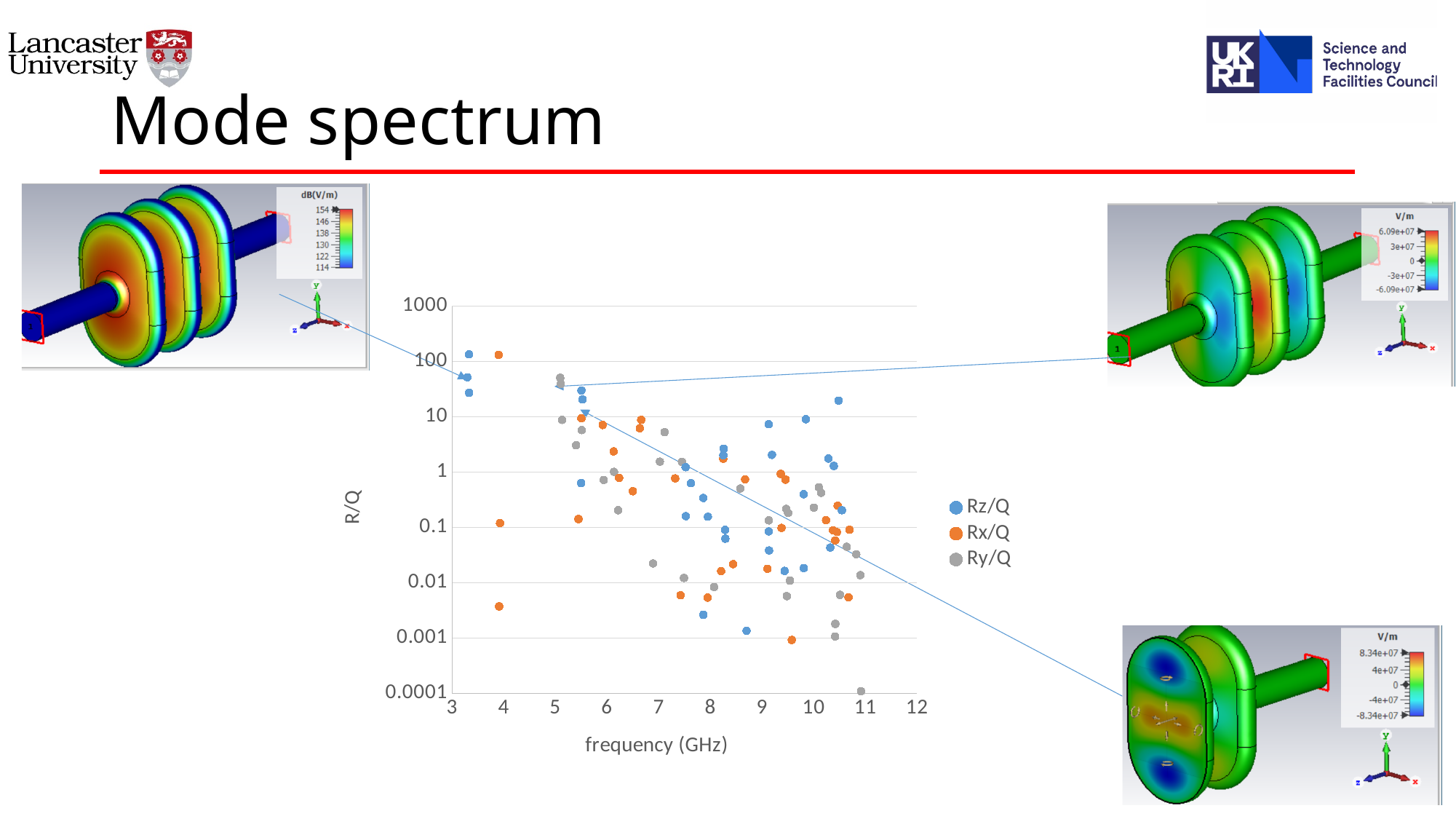
Is the lowest Ry/Q value on the chart greater or less than 0.001? less Is the highest Ry/Q value on the chart greater or less than 100? less What is the highest tick value shown on the y axis of the chart? 1000 What is the label of the y axis of the chart? R/Q What is the label of the x axis of the chart? frequency (GHz) How many series does the chart legend list? 3 Is the highest Rx/Q value on the chart greater or less than 100? greater Do the R/Q values generally rise or fall as frequency increases along the x axis? fall Which colour represents the Rx/Q series in the chart? orange What kind of chart is shown on the slide? scatter chart What are the three series listed in the chart legend? Rz/Q, Rx/Q, Ry/Q